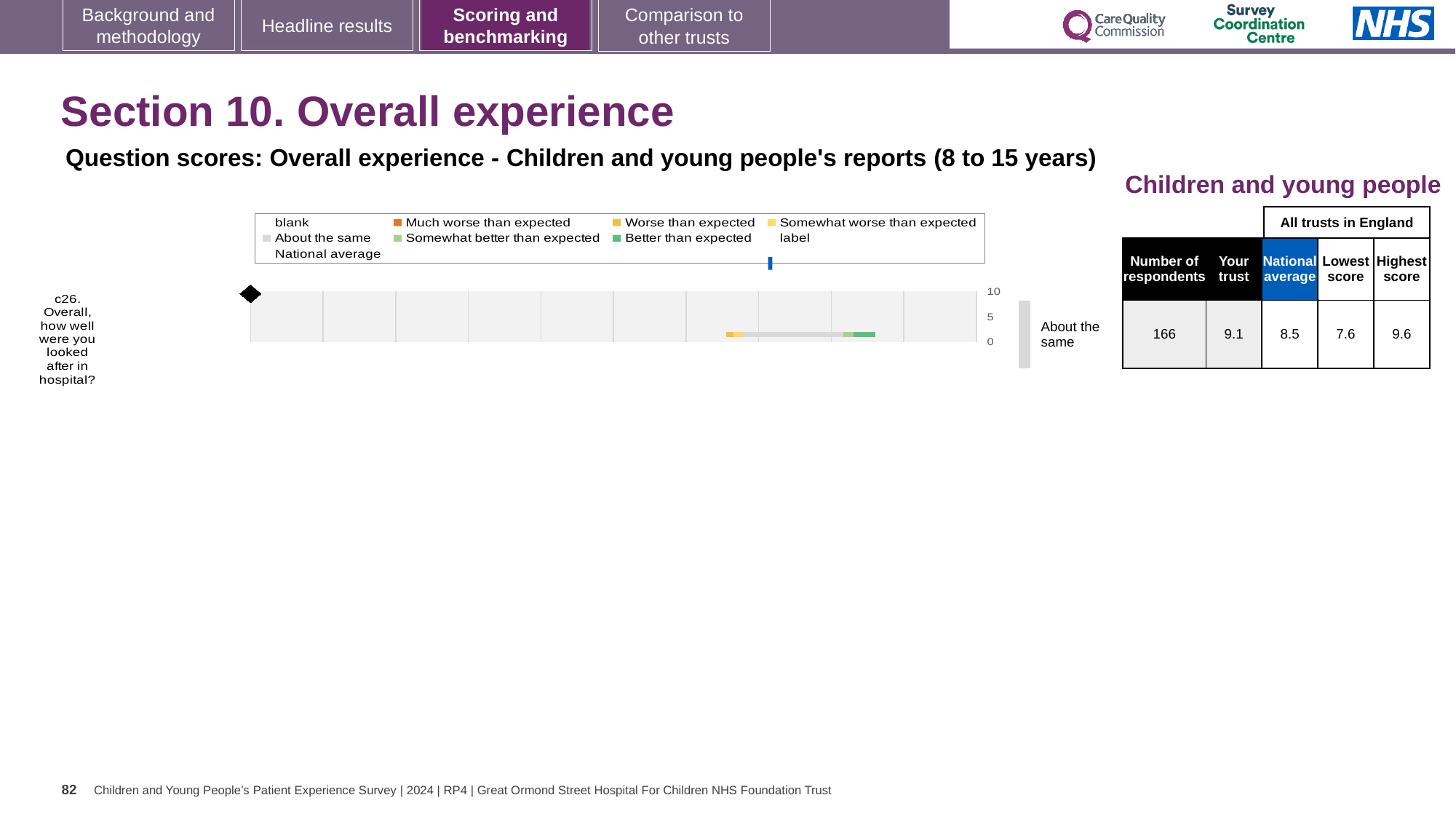
What benchmark category label is shown next to the bar for question c26? About the same Which is larger for c26: the 'Your trust' score or the national average? Your trust By how much does the 'Your trust' score for c26 exceed the national average? 0.6 In the table, what is the lowest score among all trusts in England for c26? 7.6 In the table, what is the 'Your trust' score for c26 'Overall, how well were you looked after in hospital?'? 9.1 In the table, what is the national average score for c26? 8.5 What is the highest value shown on the chart's numeric axis? 10 How many survey questions are plotted on the chart? 1 How many respondents answered question c26? 166 What kind of chart is used to show the question score for c26? bar chart What is the difference between the highest score and the lowest score for c26? 2.0 In the table, what is the highest score among all trusts in England for c26? 9.6